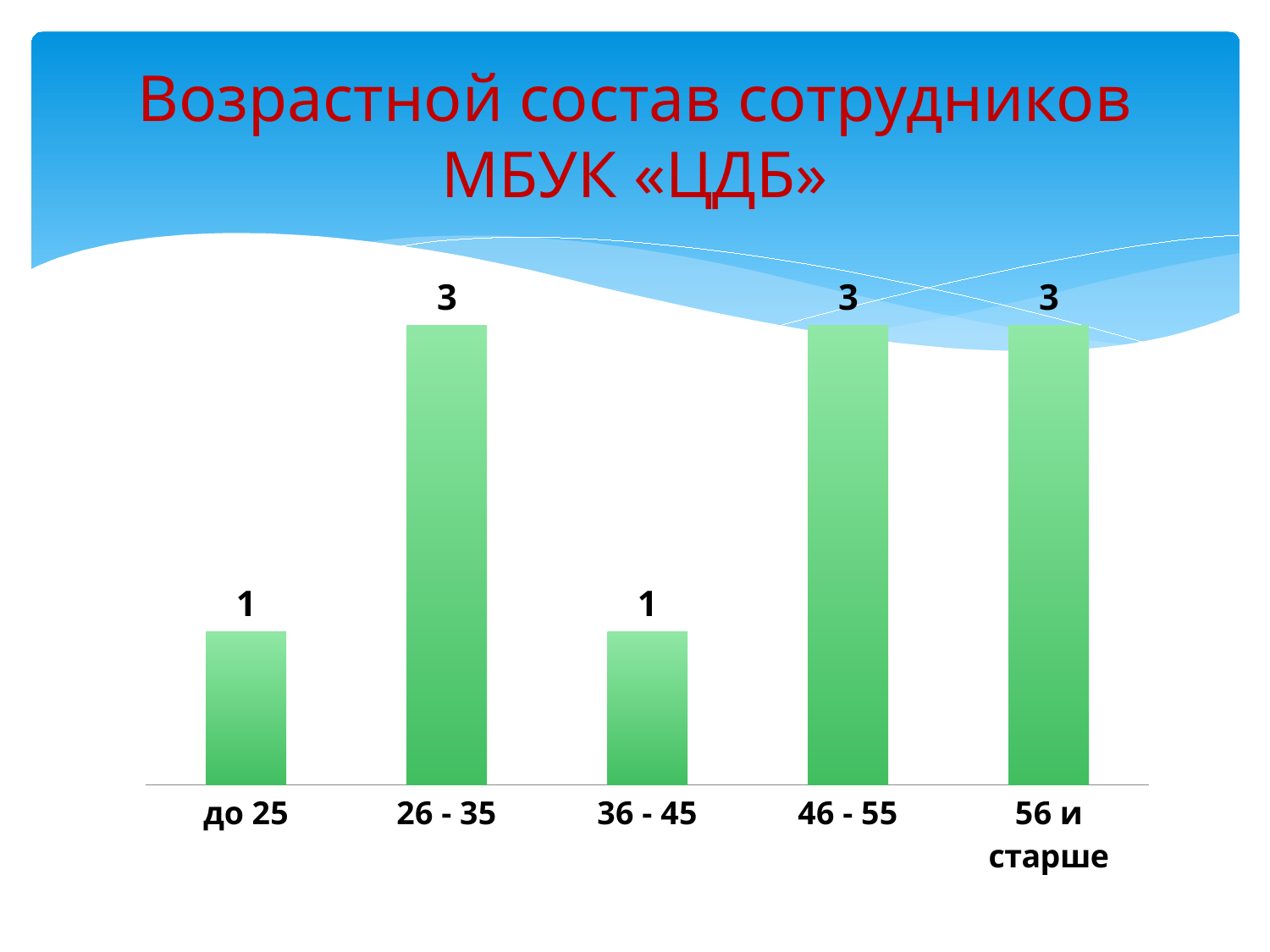
Which is larger, the value for "26 - 35" or the value for "до 25"? 26 - 35 Which age group has the lowest value, "до 25" or "26 - 35"? до 25 What kind of chart is shown on the slide? Bar chart What is the value for the "до 25" age group? 1 What is the title of the chart on the slide? Возрастной состав сотрудников МБУК «ЦДБ» How many age groups have a value of 3? 3 What is the total of all the values shown on the chart? 11 What is the value for the "36 - 45" age group? 1 What is the difference between the values for "46 - 55" and "36 - 45"? 2 How many age groups are shown on the chart? 5 What is the value for the "26 - 35" age group? 3 What is the value for the "56 и старше" age group? 3